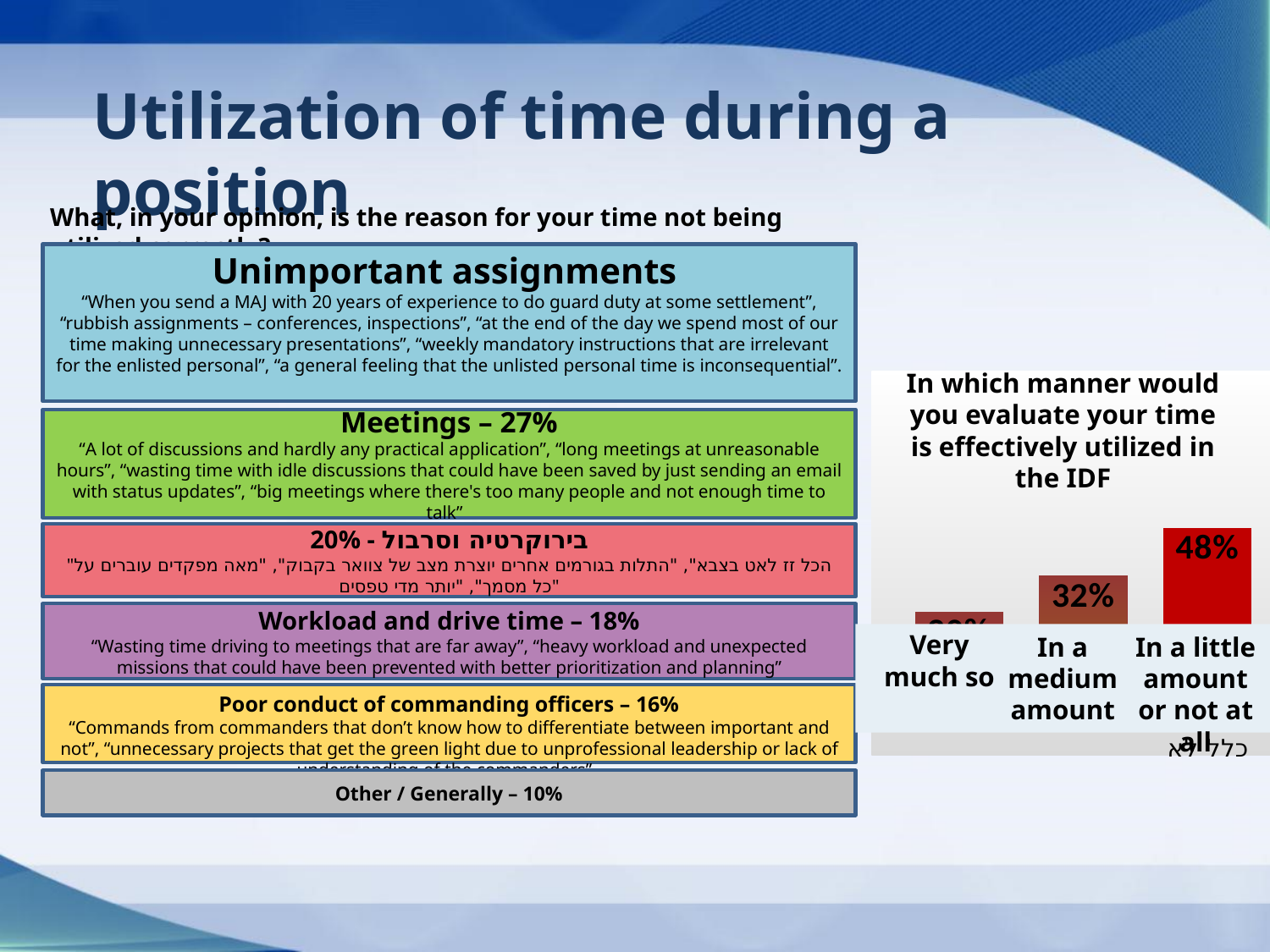
In the chart on the right, what percentage of respondents answered "In a little amount or not at all"? 48% What type of chart is shown on the right side of the slide? Bar chart In the chart on the right, which is larger: the value for "In a medium amount" or the value for "In a little amount or not at all"? In a little amount or not at all In the chart on the right, do the values rise or fall from left to right across the categories? Rise What is the title of the chart on the right side of the slide? In which manner would you evaluate your time is effectively utilized in the IDF How many response categories are shown in the chart on the right? 3 In the chart on the right, which response category has the lowest value? Very much so In the chart on the right, which response category has the highest value? In a little amount or not at all In the chart on the right, what is the difference between the values for "In a little amount or not at all" and "In a medium amount"? 16 percentage points In the chart on the right, what percentage of respondents answered "In a medium amount"? 32%